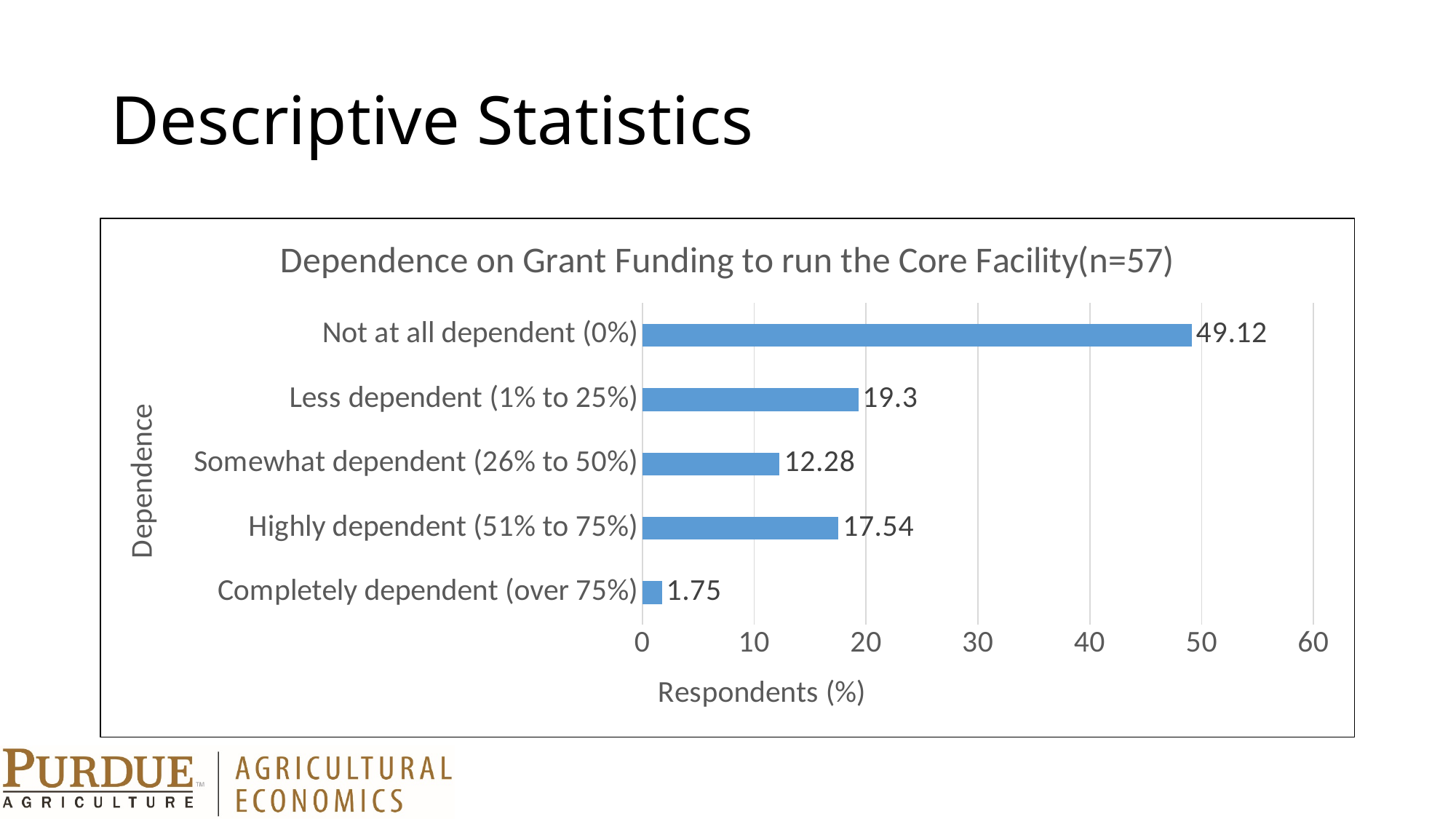
What is the value for Somewhat dependent (26% to 50%)? 12.28 Which is larger, the value for Highly dependent (51% to 75%) or Somewhat dependent (26% to 50%)? Highly dependent (51% to 75%) What is the title of the chart? Dependence on Grant Funding to run the Core Facility(n=57) How many categories are shown in the chart? 5 What is the value for Less dependent (1% to 25%)? 19.3 What is the difference between the values for Not at all dependent (0%) and Less dependent (1% to 25%)? 29.82 Which category has the lowest value? Completely dependent (over 75%) What is the value for Not at all dependent (0%)? 49.12 Which category has the highest value? Not at all dependent (0%) What is the value for Highly dependent (51% to 75%)? 17.54 What kind of chart is shown on the slide? Bar chart What is the value for Completely dependent (over 75%)? 1.75